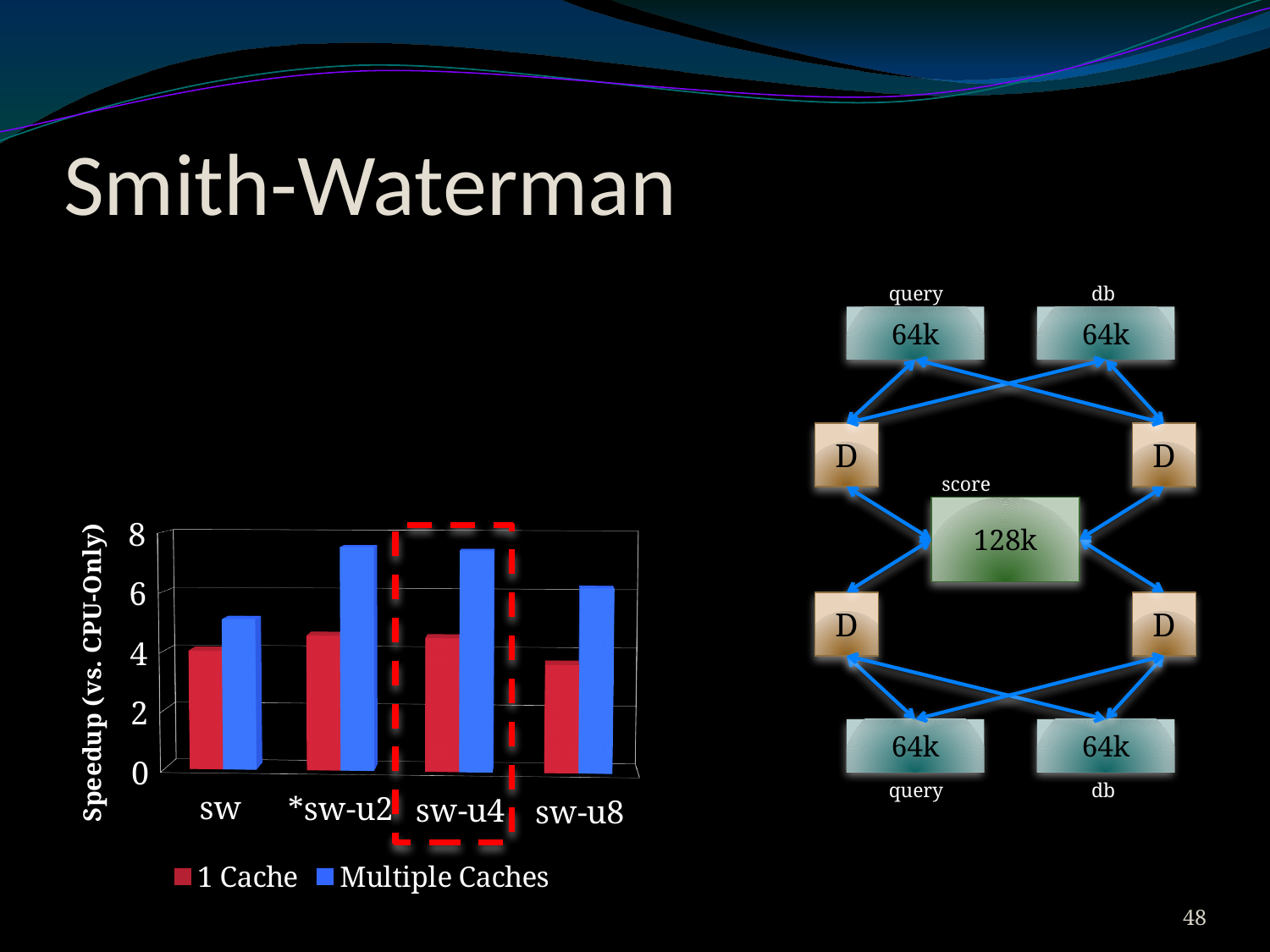
How many categories are shown on the x axis of the bar chart? 4 Is the Multiple Caches value for *sw-u2 greater or less than 6? greater Which category has the lowest Multiple Caches value? sw Is the Multiple Caches value for sw greater or less than 6? less How many series does the legend of the bar chart list? 2 What kind of chart is shown on the slide? bar chart What is the label of the y axis of the bar chart? Speedup (vs. CPU-Only) Which is larger: the Multiple Caches value for sw or the Multiple Caches value for sw-u8? sw-u8 For sw-u8, which is larger: the 1 Cache value or the Multiple Caches value? Multiple Caches Is the 1 Cache value for sw greater or less than 6? less Which category has the lowest 1 Cache value? sw-u8 What are the two series named in the legend of the bar chart? 1 Cache and Multiple Caches